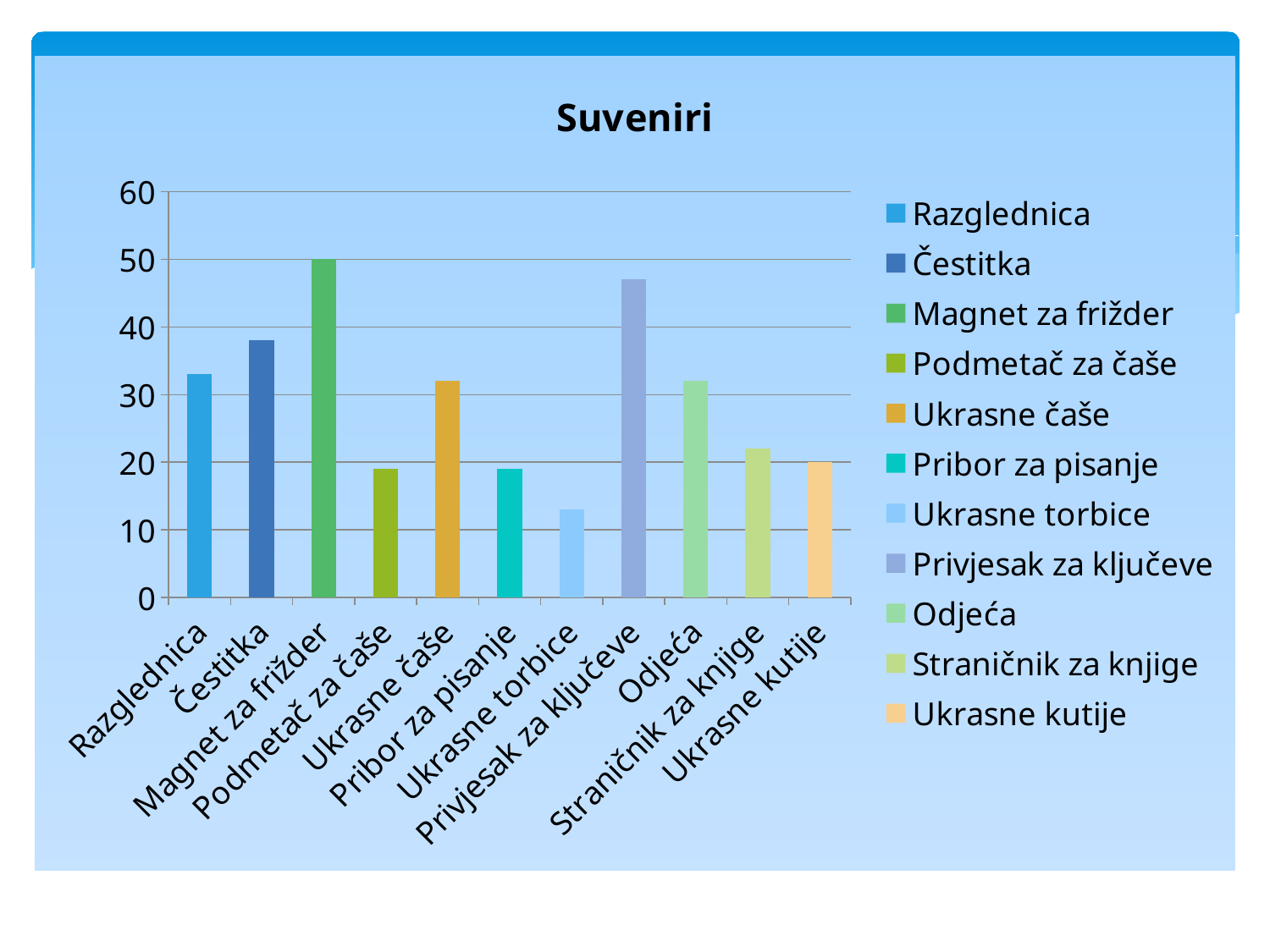
Which is larger, the value for Privjesak za ključeve or the value for Odjeća? Privjesak za ključeve What is the value for Magnet za frižder? 50 Which is larger, the value for Razglednica or the value for Podmetač za čaše? Razglednica Is the value for Čestitka greater or less than 30? greater Which category has the highest value? Magnet za frižder Is the value for Ukrasne torbice greater or less than 20? less Which category has the lowest value? Ukrasne torbice What is the title of the chart? Suveniri What type of chart is shown on the slide? bar chart How many entries does the legend list? 11 Is the value for Privjesak za ključeve greater or less than 40? greater How many categories are shown on the x axis of the chart? 11